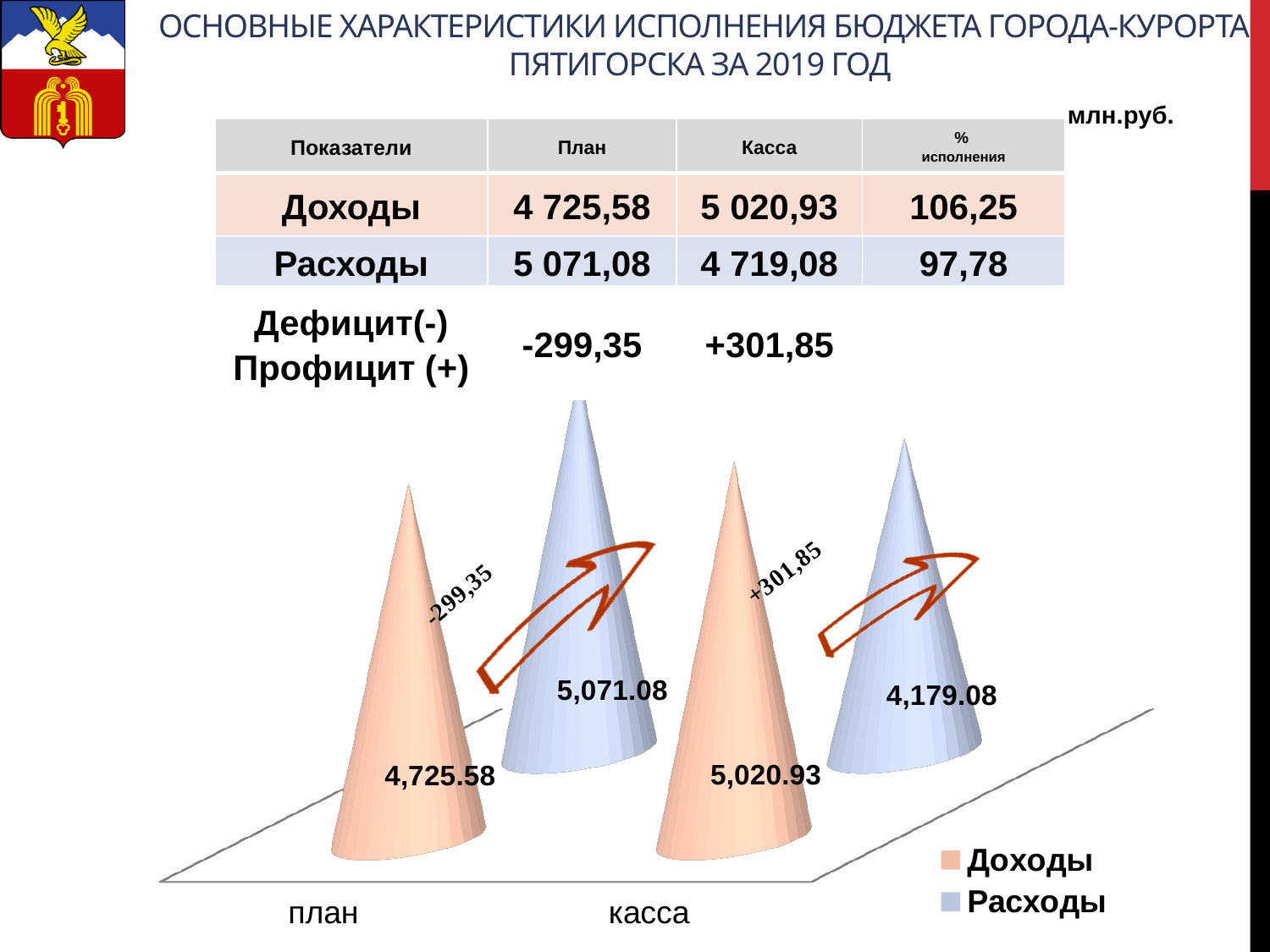
What type of chart is shown on the slide? bar chart What is the value of Доходы for касса in the chart? 5,020.93 What is the value of Доходы for план in the chart? 4,725.58 What is the value of Расходы for план in the chart? 5,071.08 What data label is shown on the Расходы cone for касса in the chart? 4,179.08 How many series does the chart legend list? 2 What annotation is written next to the arrow between the план cones in the chart? -299,35 Does the value of Доходы rise or fall from план to касса in the chart? rise How many categories are shown on the x axis of the chart? 2 In the chart, which series has the higher value for план, Доходы or Расходы? Расходы What annotation is written next to the arrow between the касса cones in the chart? +301,85 In the chart, which series has the higher value for касса, Доходы or Расходы? Доходы